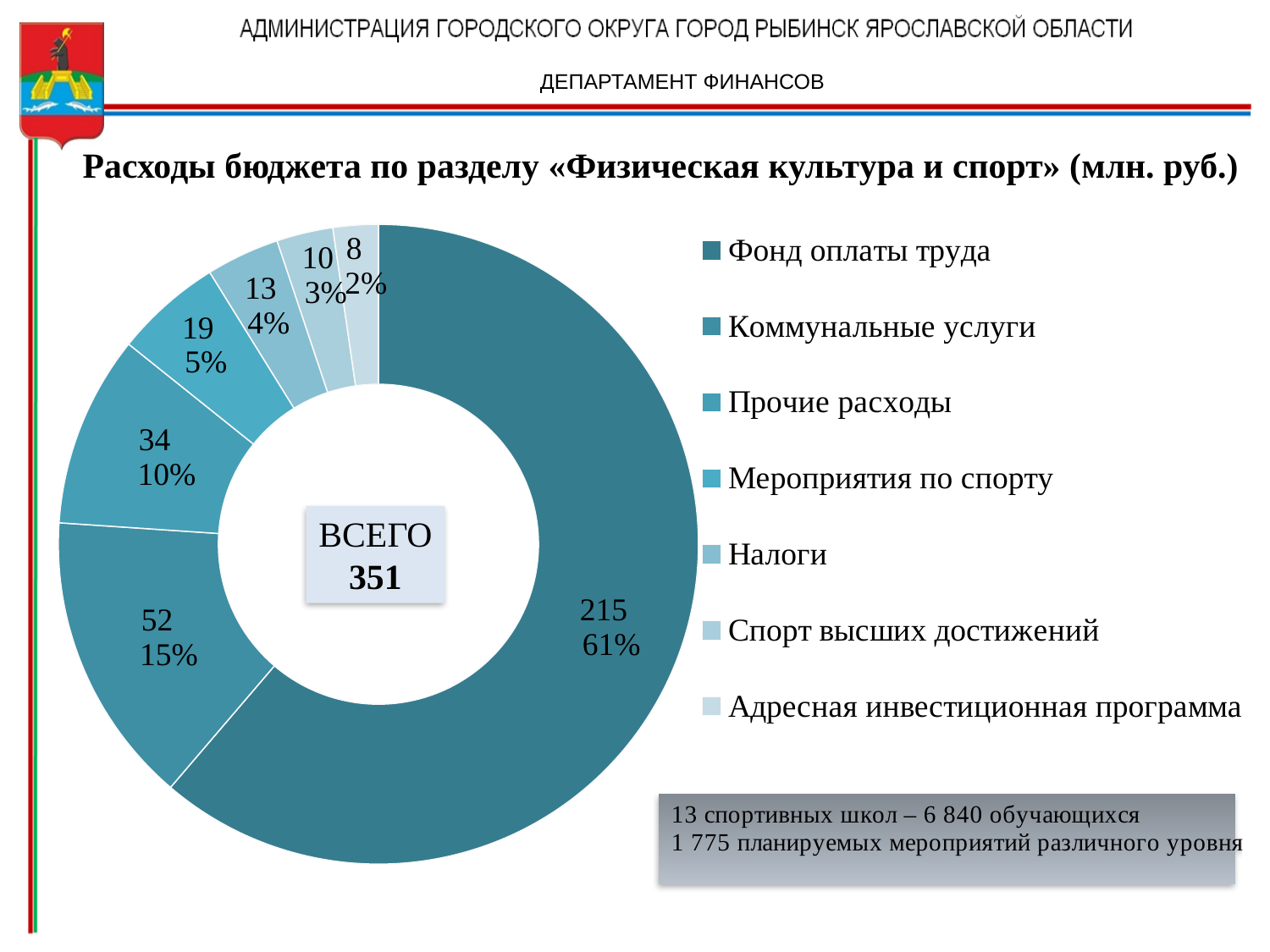
What share of the total does «Адресная инвестиционная программа» account for? 2% What share of the total does «Прочие расходы» account for? 10% Which is larger: «Налоги» or «Спорт высших достижений»? Налоги How many categories does the chart show? 7 What is the value for «Мероприятия по спорту»? 19 Which category has the largest value? Фонд оплаты труда What is the difference between «Фонд оплаты труда» and «Коммунальные услуги»? 163 What is the value for «Коммунальные услуги»? 52 What total (ВСЕГО) is shown in the centre of the chart? 351 What type of chart is shown on the slide? Doughnut (pie) chart What is the value for «Фонд оплаты труда»? 215 Which category has the smallest value? Адресная инвестиционная программа